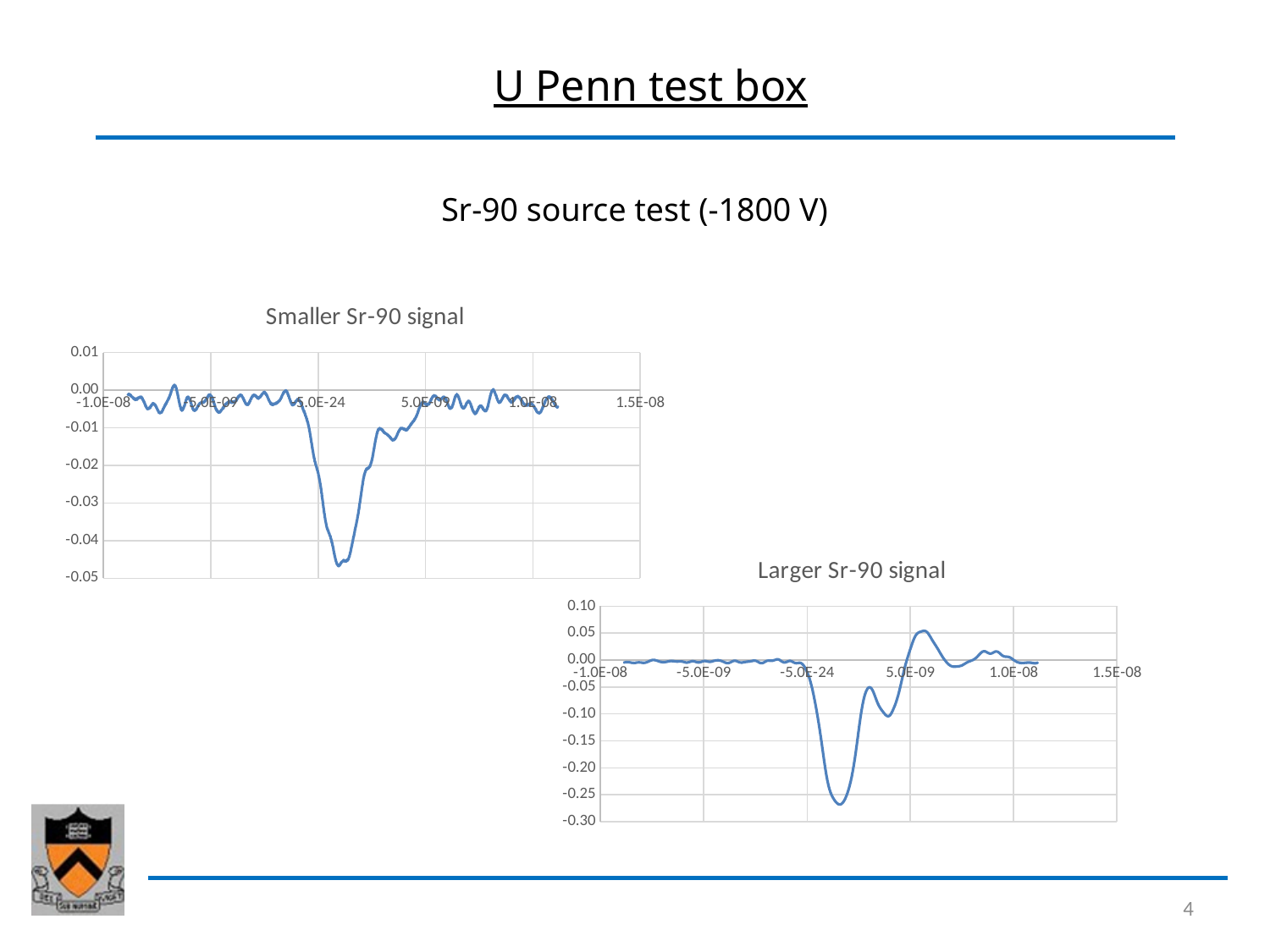
On the 'Smaller Sr-90 signal' chart, is the highest value of the line greater or less than 0.01? less What is the title of the chart on the left of the slide? Smaller Sr-90 signal On the 'Larger Sr-90 signal' chart, is the highest value of the line greater or less than 0.00? greater On the 'Larger Sr-90 signal' chart, is the lowest value of the line greater or less than -0.30? greater Which chart shows the deeper negative dip, 'Smaller Sr-90 signal' or 'Larger Sr-90 signal'? Larger Sr-90 signal What is the title of the chart on the lower right of the slide? Larger Sr-90 signal What kind of chart is the 'Smaller Sr-90 signal' chart? line chart What kind of chart is the 'Larger Sr-90 signal' chart? line chart